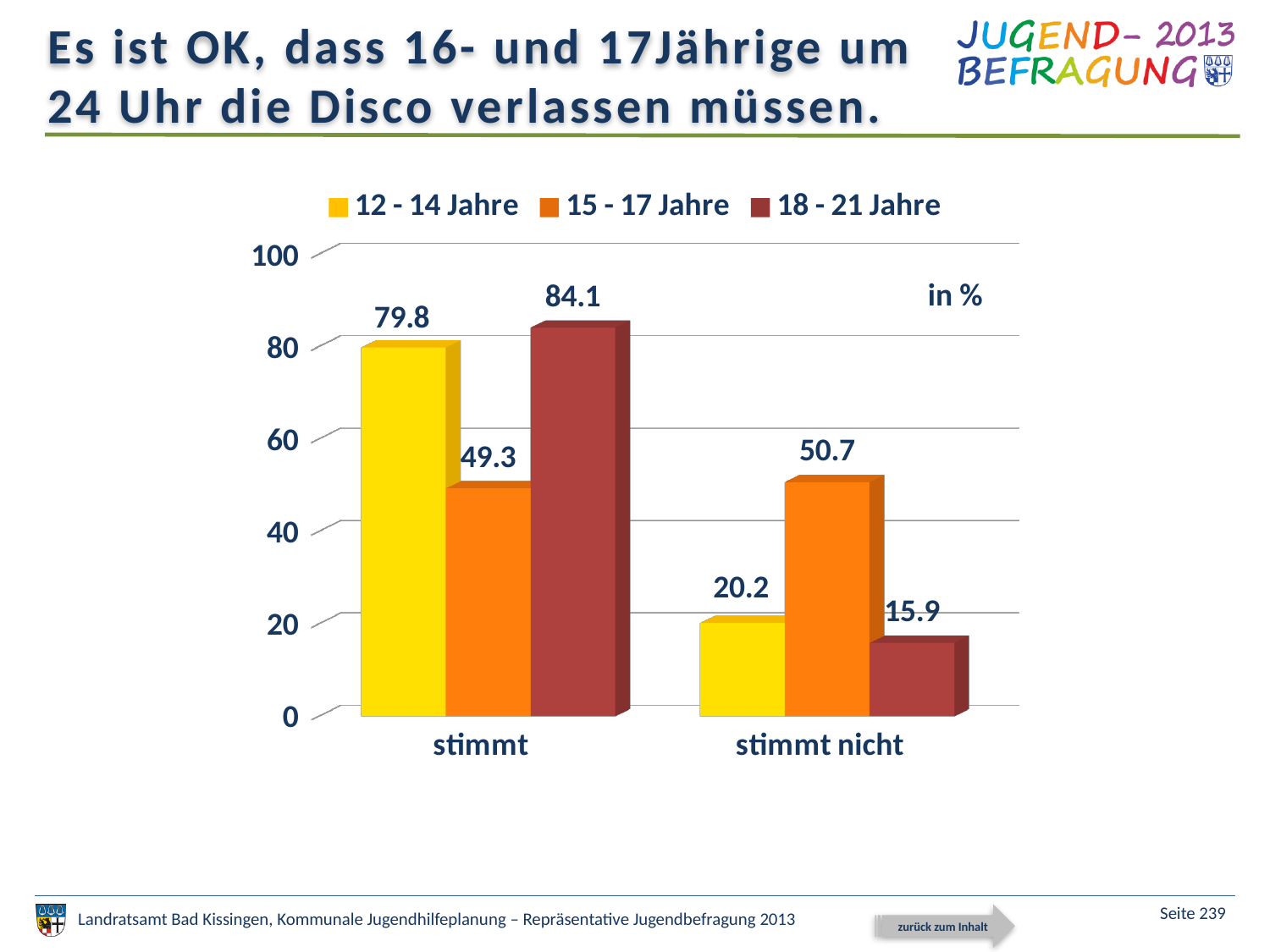
What is the value for the 15 - 17 Jahre series in the stimmt nicht category? 50.7 What is the difference between the 18 - 21 Jahre and 15 - 17 Jahre values in the stimmt category? 34.8 What is the value for the 18 - 21 Jahre series in the stimmt category? 84.1 How many series does the legend list? 3 Is the value for 15 - 17 Jahre in the stimmt category greater or less than 60? less Which age group has the lowest value in the stimmt nicht category? 18 - 21 Jahre What is the value for the 12 - 14 Jahre series in the stimmt category? 79.8 What kind of chart is shown on the slide? bar chart How many categories are shown on the x axis? 2 Which age group has the highest value in the stimmt category? 18 - 21 Jahre What unit is indicated for the values in the chart? in % Which is larger: the 12 - 14 Jahre value for stimmt nicht or the 18 - 21 Jahre value for stimmt nicht? 12 - 14 Jahre